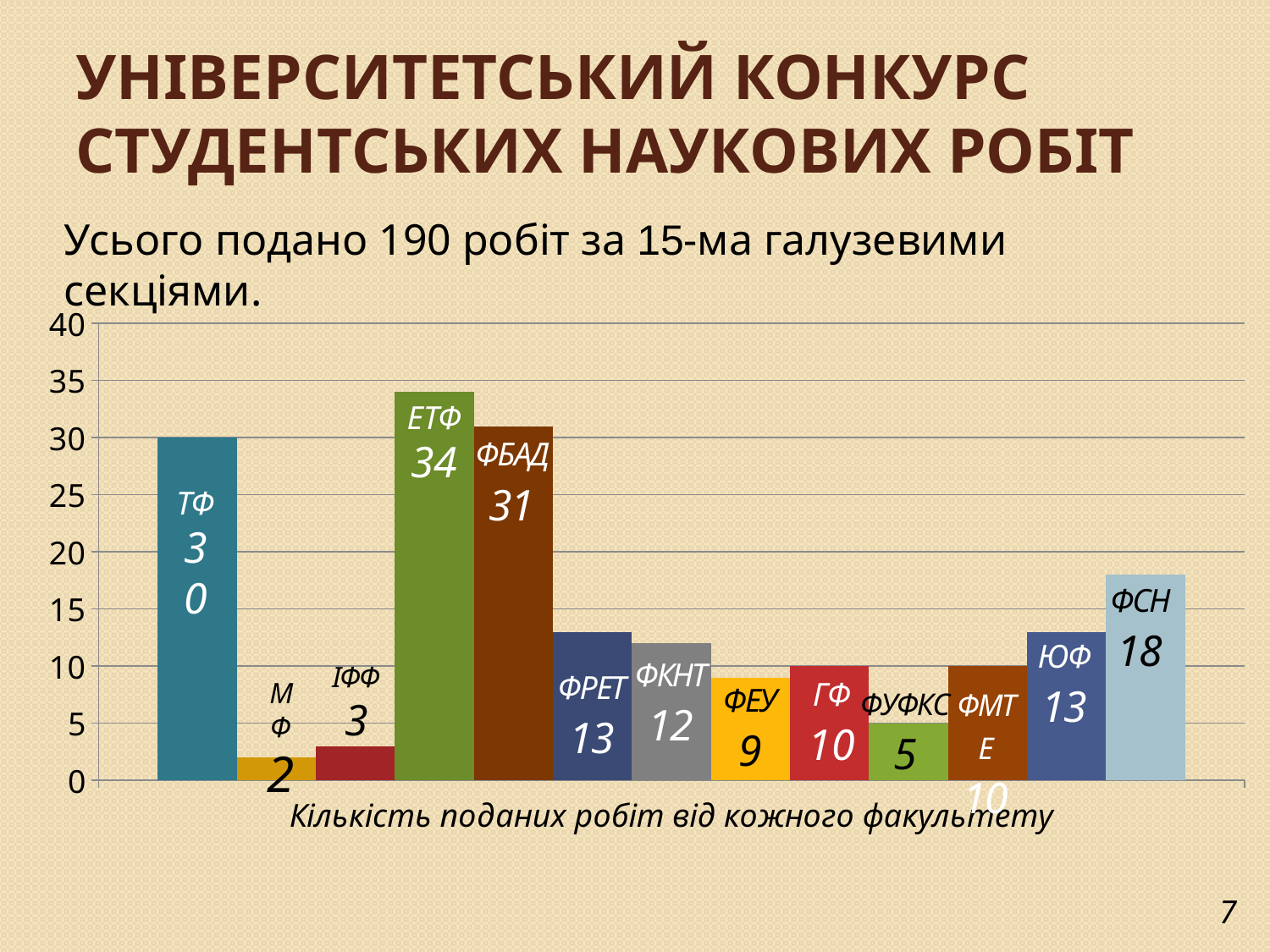
Which faculty has the highest number of submitted works? ЕТФ Which faculty has the lowest number of submitted works? МФ What type of chart is shown on the slide? Bar chart Is the value for ФБАД greater or less than 30? greater What is the difference between the values for ЕТФ and ФБАД? 3 What is the value shown for ФСН? 18 What is the difference between the values for ТФ and ФСН? 12 What is the caption text shown below the bars of the chart? Кількість поданих робіт від кожного факультету Which is larger, the value for ФРЕТ or the value for ФЕУ? ФРЕТ How many works were submitted by ЕТФ? 34 How many faculties (bars) are shown in the chart? 13 What is the value shown for ФКНТ? 12